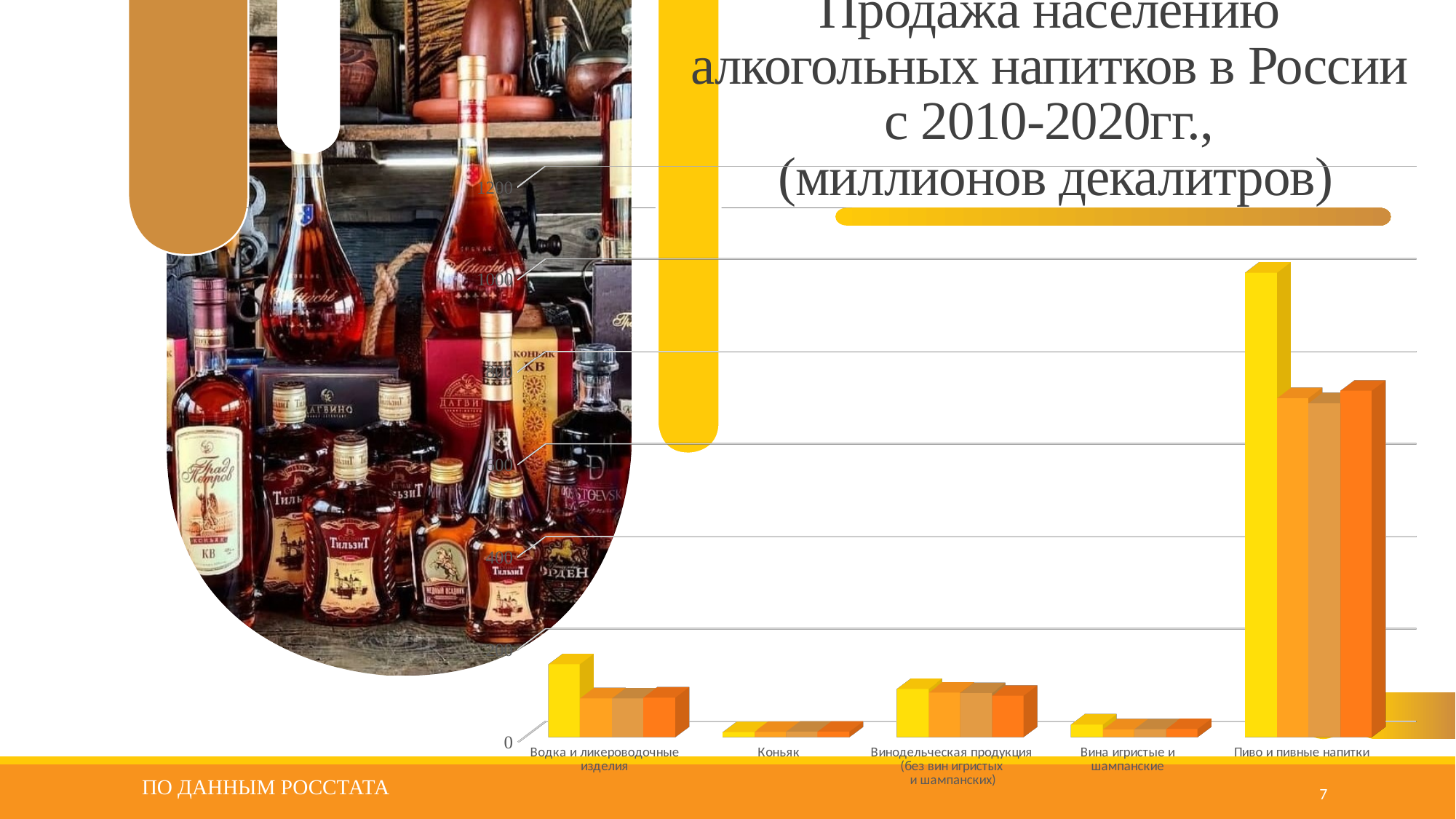
How many product categories are shown on the x axis of the chart? 5 What kind of chart is shown on the slide? bar chart Which has the taller first (yellow) bar: Водка и ликероводочные изделия or Вина игристые и шампанские? Водка и ликероводочные изделия Is the tallest bar for Винодельческая продукция (без вин игристых и шампанских) greater or less than 400? less Which category has the lowest bars in the chart? Коньяк Is the tallest bar for Пиво и пивные напитки greater or less than 800? greater Is the tallest bar for Водка и ликероводочные изделия greater or less than 400? less Which category has the highest bars in the chart? Пиво и пивные напитки For Пиво и пивные напитки, is the first (yellow) bar higher or lower than the bars that follow it? higher Which has the taller bars: Вина игристые и шампанские or Коньяк? Вина игристые и шампанские What unit of measurement is given in the chart title? миллионов декалитров